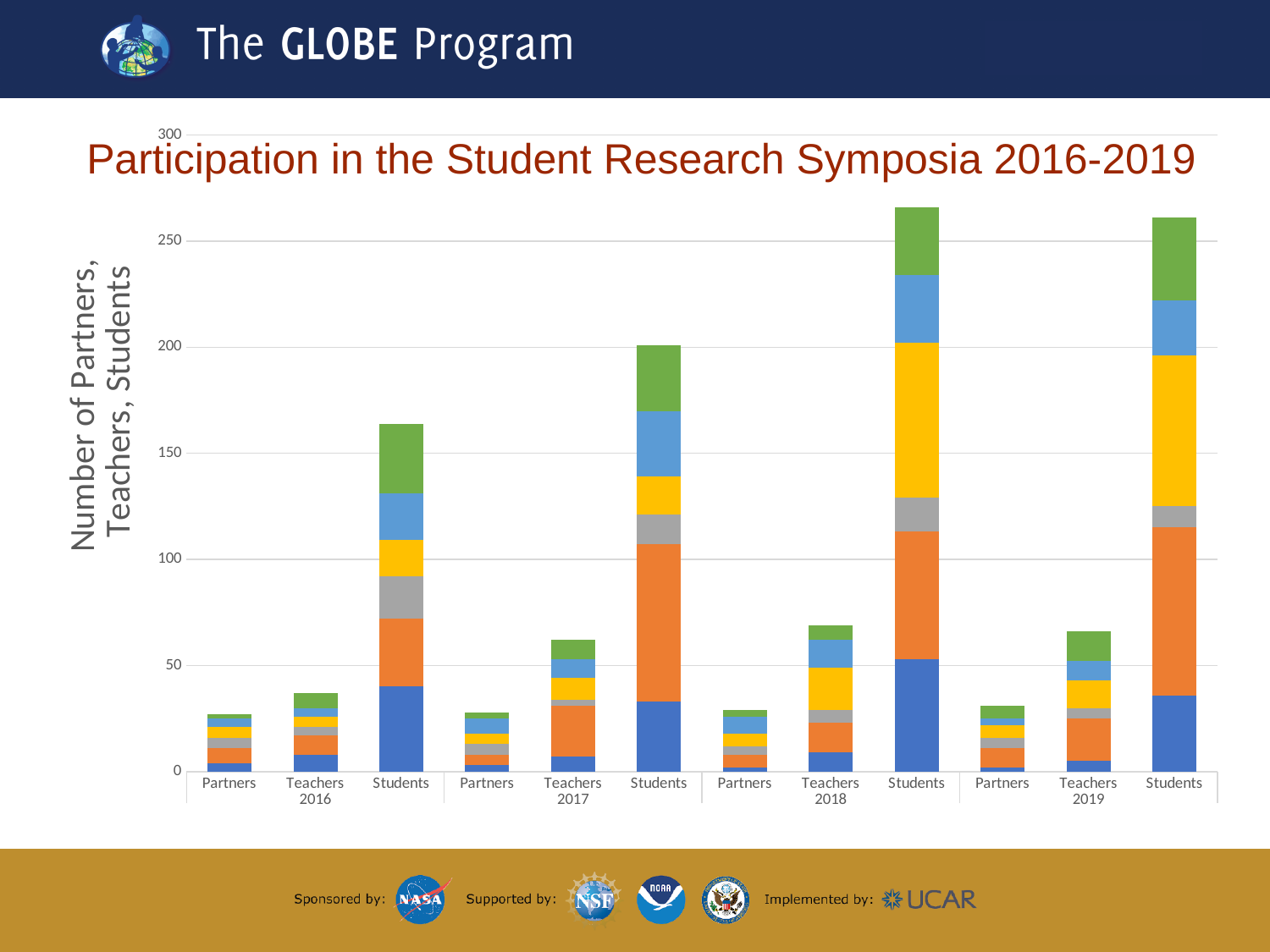
Is the total value of the Students bar for 2016 greater or less than 150? greater Do the Students bars rise or fall from 2016 to 2018? rise Which is taller, the Students bar for 2016 or the Students bar for 2017? Students 2017 Is the total value of the Teachers bar for 2018 greater or less than 50? greater What is the title of the chart? Participation in the Student Research Symposia 2016-2019 What kind of chart is shown on the slide? Stacked bar chart Is the total value of the Students bar for 2018 greater or less than 250? greater What is the label on the vertical axis of the chart? Number of Partners, Teachers, Students How many years are shown along the x axis of the chart? 4 How many bars are plotted in the chart? 12